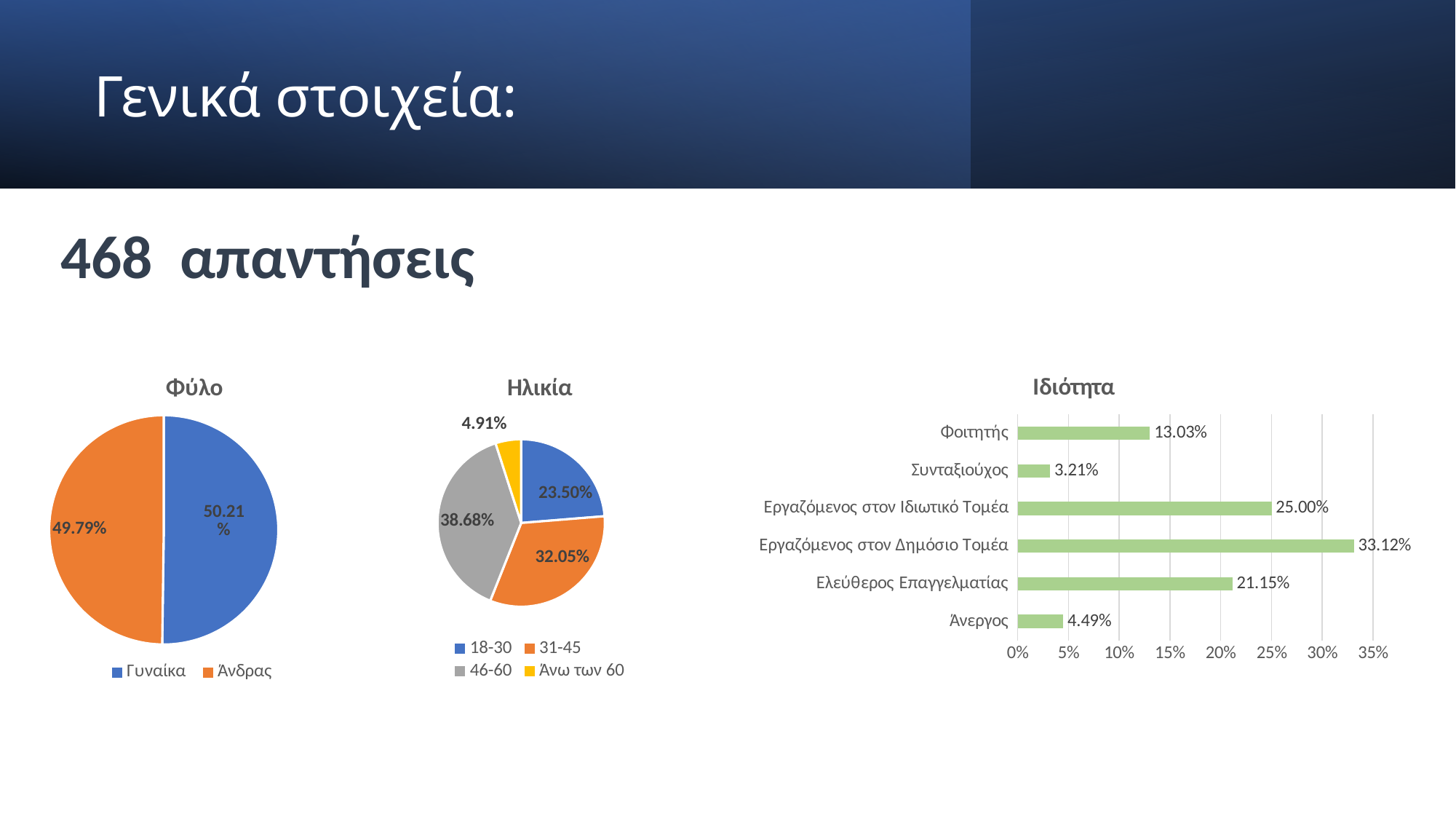
In the 'Φύλο' pie chart, what share does Άνδρας have? 49.79% In the 'Ηλικία' pie chart, which age group has the largest share? 46-60 In the 'Ηλικία' pie chart, which age group has the smallest share? Άνω των 60 In the 'Ηλικία' pie chart, what is the difference between the 31-45 share and the 18-30 share? 8.55% In the 'Ιδιότητα' chart, which is larger: Φοιτητής or Ελεύθερος Επαγγελματίας? Ελεύθερος Επαγγελματίας In the 'Ιδιότητα' chart, how many categories are shown? 6 In the 'Ιδιότητα' chart, which category has the lowest value? Συνταξιούχος In the 'Ιδιότητα' chart, what is the value for Εργαζόμενος στον Δημόσιο Τομέα? 33.12% What kind of chart is the 'Ιδιότητα' chart? Bar chart In the 'Ηλικία' pie chart, how many age groups are shown? 4 In the 'Ηλικία' pie chart, what share does the 46-60 group have? 38.68% In the 'Φύλο' pie chart, what share does Γυναίκα have? 50.21%